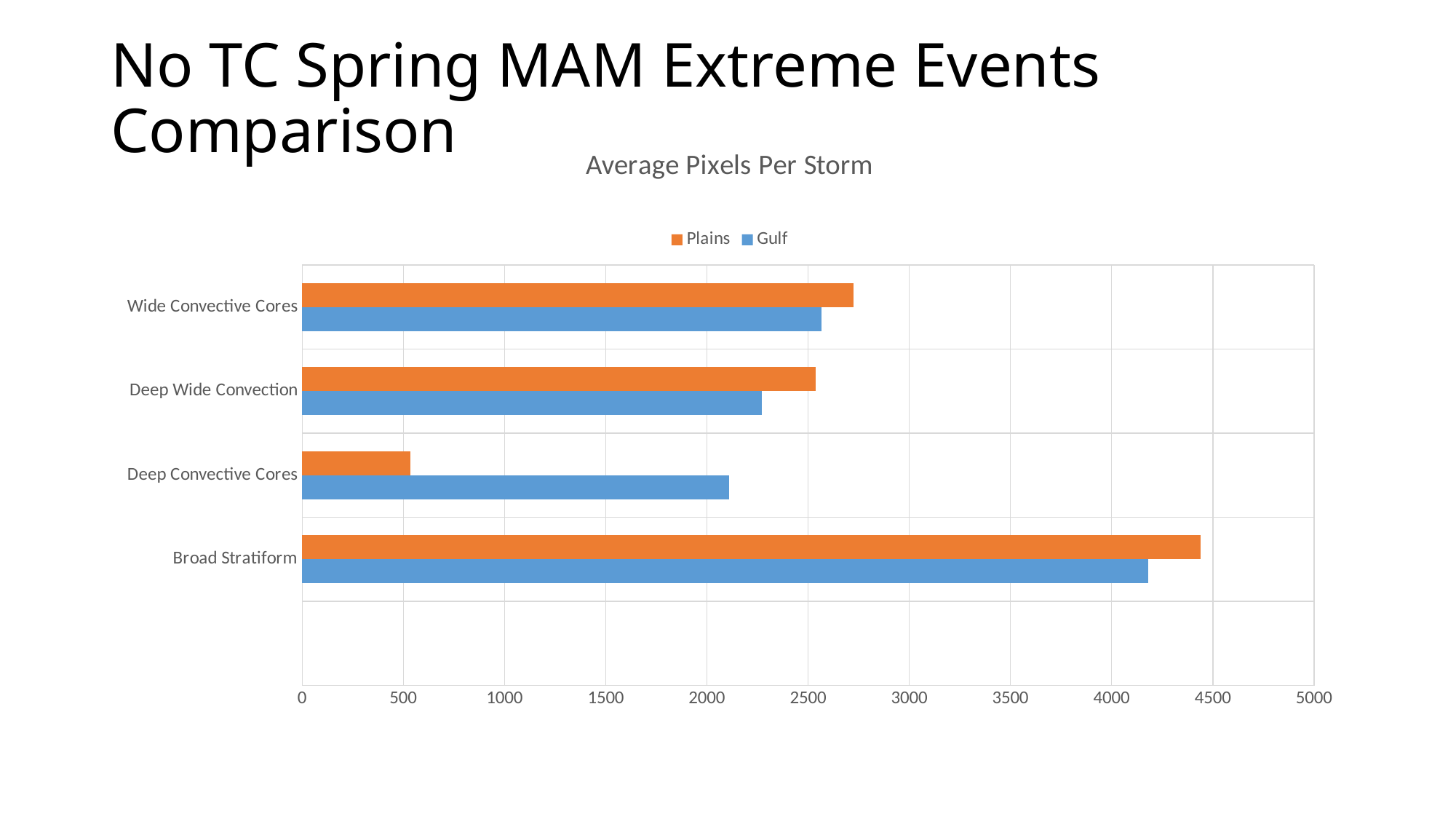
For Deep Convective Cores, which series has the larger value, Plains or Gulf? Gulf Which category has the highest Gulf value? Broad Stratiform Which category has the highest Plains value? Broad Stratiform Is the Plains value for Deep Convective Cores greater or less than 1000? less How many series does the legend list? 2 Is the Plains value for Broad Stratiform greater or less than 4000? greater Which category has the lowest Plains value? Deep Convective Cores What is the title of the chart? Average Pixels Per Storm How many categories are shown on the chart? 4 Is the Gulf value for Deep Wide Convection greater or less than 2500? less What kind of chart is shown on the slide? bar chart For Broad Stratiform, which series has the larger value, Plains or Gulf? Plains